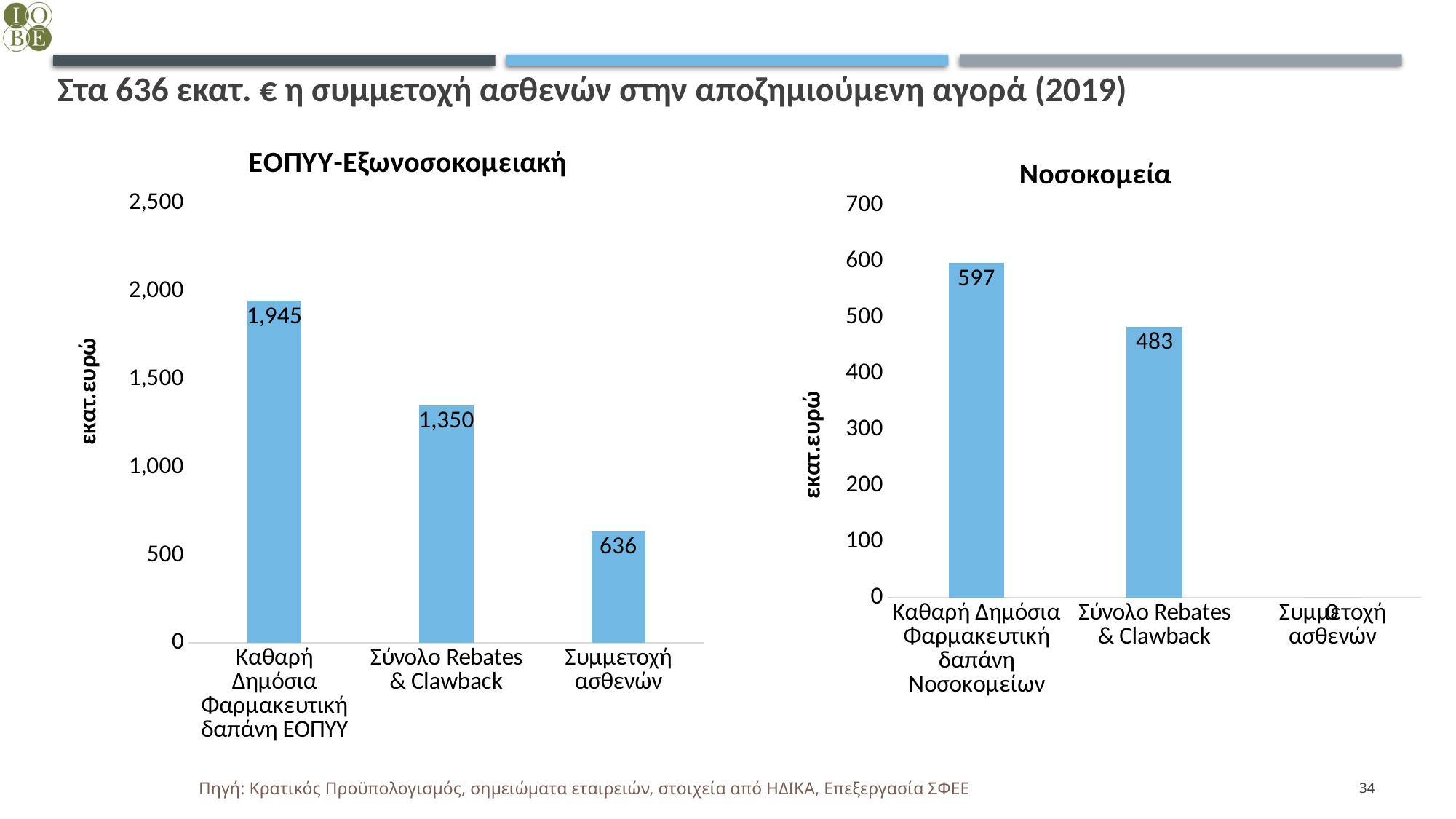
In the ΕΟΠΥΥ-Εξωνοσοκομειακή chart, what is the difference between Καθαρή Δημόσια Φαρμακευτική δαπάνη ΕΟΠΥΥ and Σύνολο Rebates & Clawback? 595 In the Νοσοκομεία chart, what is the value for Σύνολο Rebates & Clawback? 483 In the Νοσοκομεία chart, which category has the lowest value? Συμμετοχή ασθενών What type of chart is the ΕΟΠΥΥ-Εξωνοσοκομειακή chart? Bar chart In the ΕΟΠΥΥ-Εξωνοσοκομειακή chart, what is the value for Καθαρή Δημόσια Φαρμακευτική δαπάνη ΕΟΠΥΥ? 1,945 In the Νοσοκομεία chart, what is the value for Συμμετοχή ασθενών? 0 In the Νοσοκομεία chart, what is the difference between Καθαρή Δημόσια Φαρμακευτική δαπάνη Νοσοκομείων and Σύνολο Rebates & Clawback? 114 In the ΕΟΠΥΥ-Εξωνοσοκομειακή chart, which category has the highest value? Καθαρή Δημόσια Φαρμακευτική δαπάνη ΕΟΠΥΥ How many categories are shown in the Νοσοκομεία chart? 3 In the Νοσοκομεία chart, what is the value for Καθαρή Δημόσια Φαρμακευτική δαπάνη Νοσοκομείων? 597 In the ΕΟΠΥΥ-Εξωνοσοκομειακή chart, what is the value for Σύνολο Rebates & Clawback? 1,350 In the ΕΟΠΥΥ-Εξωνοσοκομειακή chart, what is the value for Συμμετοχή ασθενών? 636